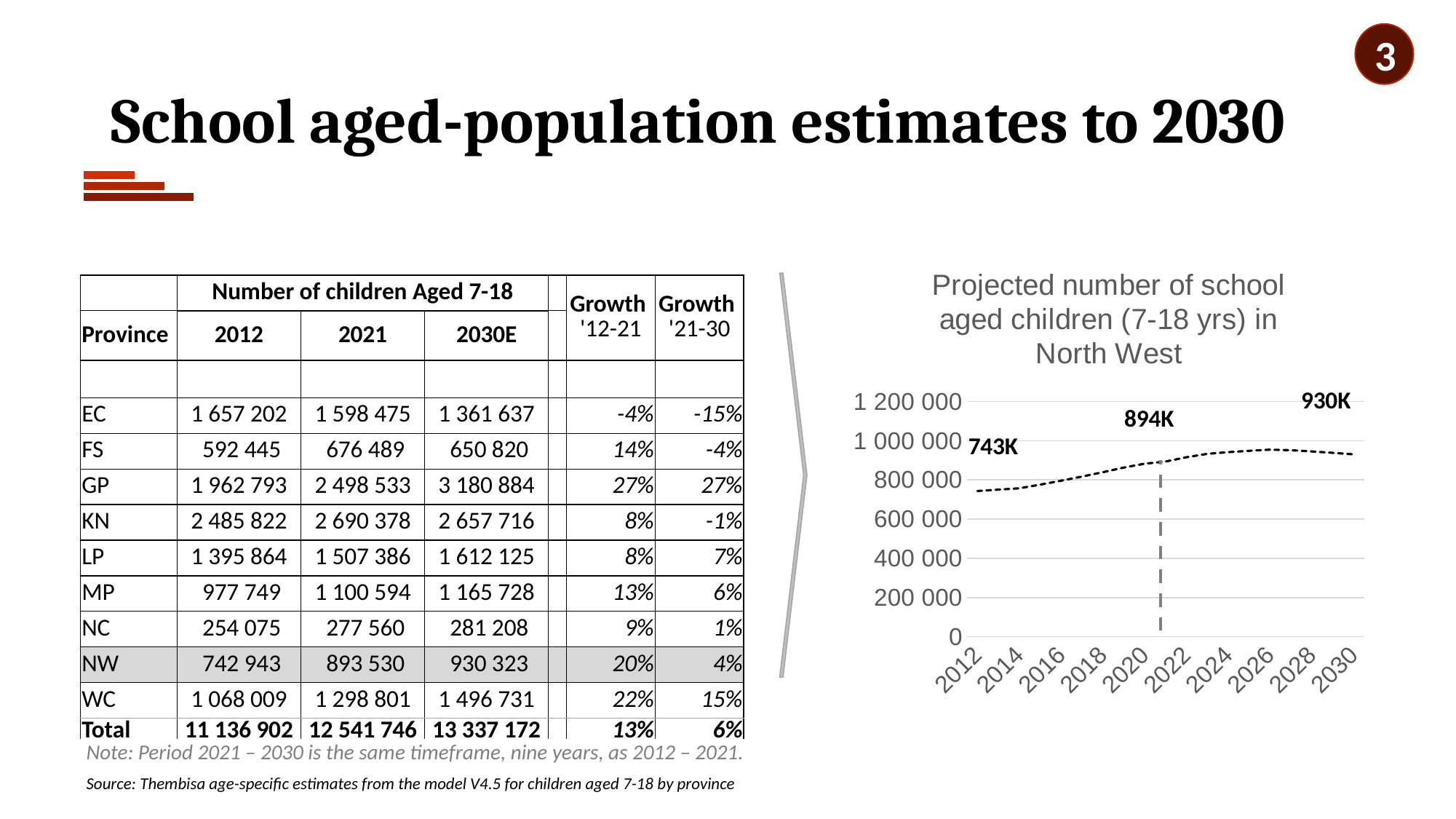
How many year labels are shown on the x axis of the chart? 10 What is the title of the chart on the slide? Projected number of school aged children (7-18 yrs) in North West In the chart, which is larger: the value for 2012 or the value for 2021? 2021 What type of chart is shown on the right of the slide? line chart In the chart, is the value for 2016 greater or less than 1 000 000? less Does the line in the chart generally rise or fall from 2012 to 2030? rise In the chart, what value is labelled for 2012? 743K Which labelled year in the chart has the lowest value? 2012 In the chart, what value is labelled for 2030? 930K Which labelled year in the chart has the highest value? 2030 In the chart, what is the difference between the 2030 value and the 2012 value? 187K In the chart, what value is labelled for 2021? 894K